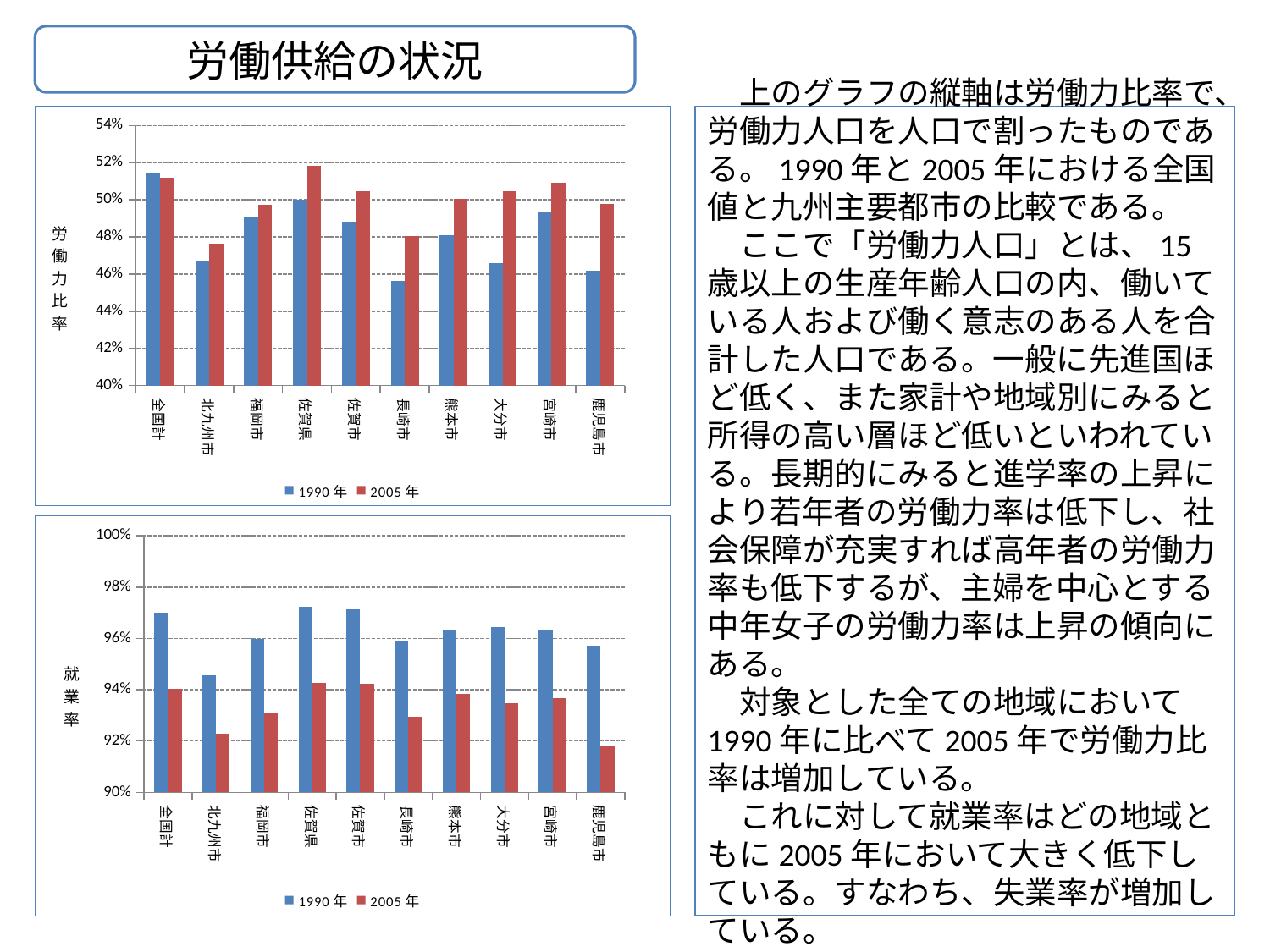
What kind of chart is the bottom chart (就業率)? Bar chart In the bottom chart (就業率), which category has the lowest value for 1990年? 北九州市 In the top chart (労働力比率), how many categories are shown on the x axis? 10 In the top chart (労働力比率), how many series does the legend list? 2 In the top chart (労働力比率), is the 1990年 value for 全国計 greater or less than 50%? greater In the bottom chart (就業率), is the 2005年 value for 鹿児島市 greater or less than 92%? less In the top chart (労働力比率), is the 1990年 value for 長崎市 greater or less than 46%? less In the top chart (労働力比率), which category has the highest value for 2005年? 佐賀県 In the top chart (労働力比率), which category has the lowest value for 2005年? 北九州市 In the bottom chart (就業率), which is larger for 福岡市: the 1990年 value or the 2005年 value? 1990年 In the top chart (労働力比率), which category has the lowest value for 1990年? 長崎市